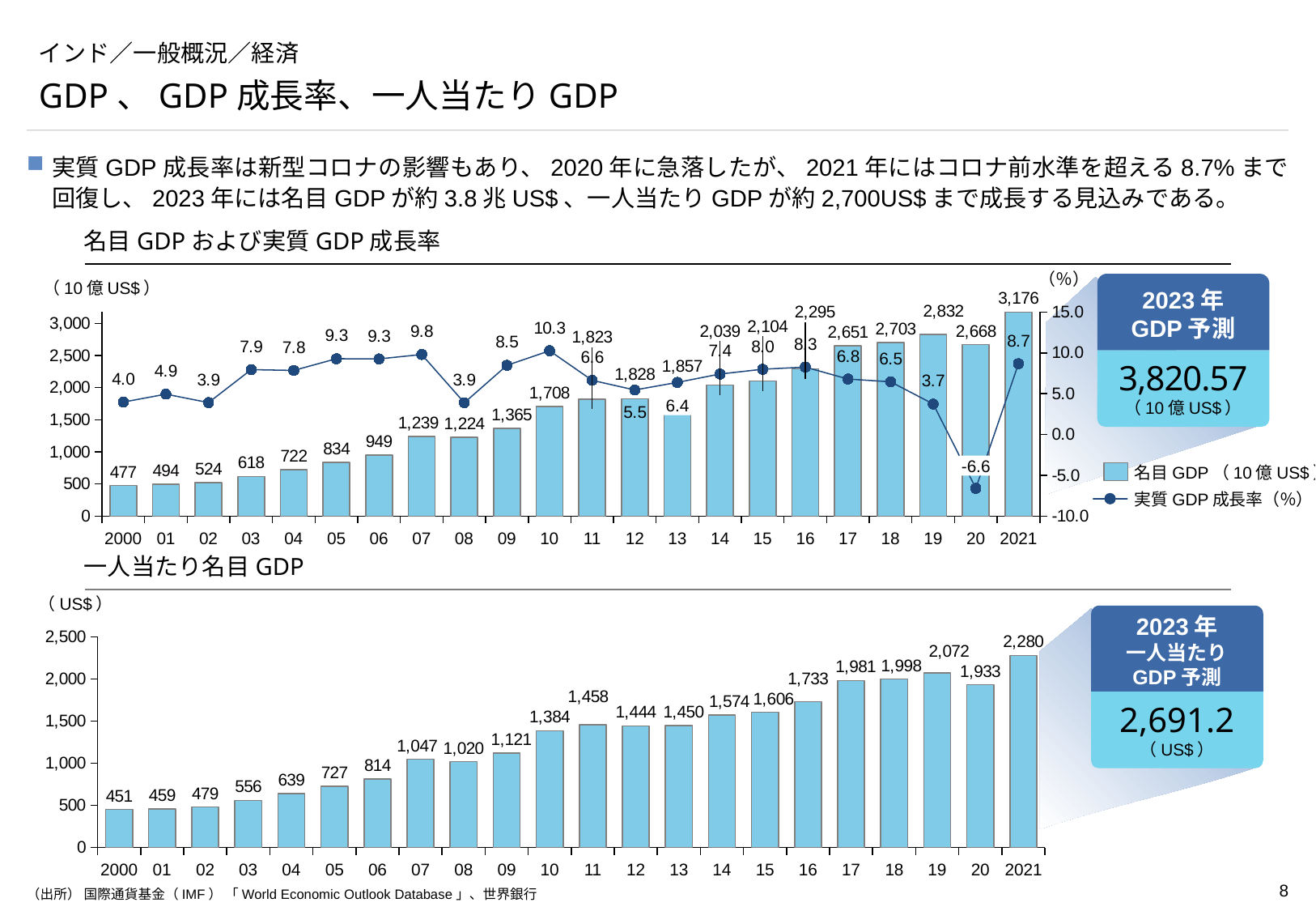
In the top chart (名目GDPおよび実質GDP成長率), what is the difference in nominal GDP between 2021 and 20? 508 In the top chart (名目GDPおよび実質GDP成長率), what is the nominal GDP value for 2021? 3,176 In the top chart (名目GDPおよび実質GDP成長率), is the real GDP growth rate for 2021 greater or less than the rate for 19? greater In the top chart (名目GDPおよび実質GDP成長率), which year has the highest real GDP growth rate? 10 In the bottom chart (一人当たり名目GDP), how many years are plotted? 22 What kind of chart is the bottom chart (一人当たり名目GDP)? Bar chart In the top chart (名目GDPおよび実質GDP成長率), what is the real GDP growth rate for 2020? -6.6 In the bottom chart (一人当たり名目GDP), what is the value for 2021? 2,280 In the bottom chart (一人当たり名目GDP), which year has the highest value? 2021 In the top chart (名目GDPおよび実質GDP成長率), which year has the lowest nominal GDP? 2000 In the top chart (名目GDPおよび実質GDP成長率), how many series does the legend list? 2 In the bottom chart (一人当たり名目GDP), what is the difference between the values for 19 and 20? 139